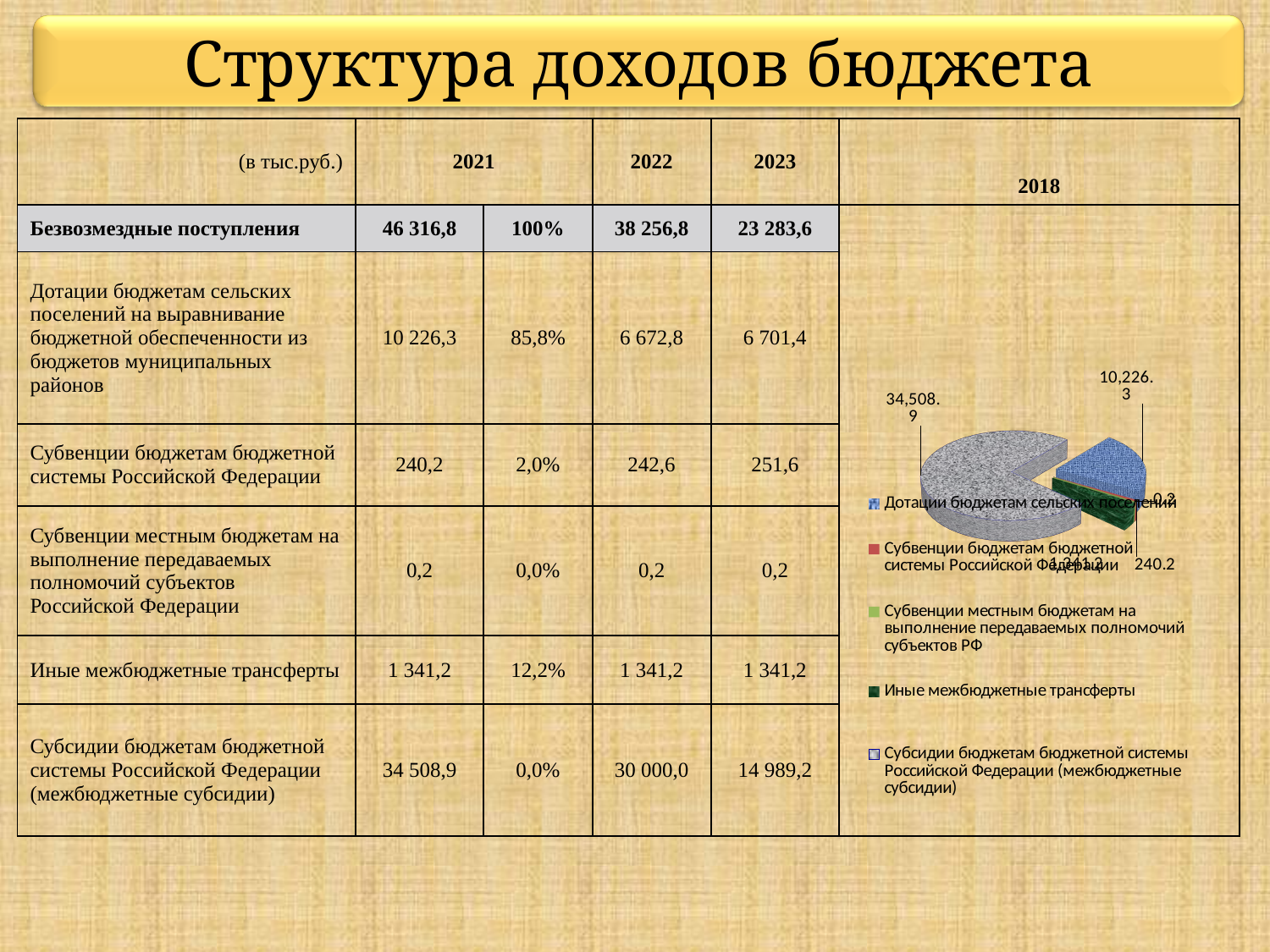
In the pie chart, what value is labelled for Дотации бюджетам сельских поселений? 10,226.3 How many entries does the legend of the pie chart list? 5 What is the title of the pie chart? 2018 In the pie chart, which is larger: the value for Дотации бюджетам сельских поселений or the value for Субвенции бюджетам бюджетной системы Российской Федерации? Дотации бюджетам сельских поселений What kind of chart is shown on the right of the slide? pie chart What colour is the largest slice of the pie chart? grey Which category has the smallest slice in the pie chart? Субвенции местным бюджетам на выполнение передаваемых полномочий субъектов РФ In the pie chart, what value is labelled for Субвенции местным бюджетам на выполнение передаваемых полномочий субъектов РФ? 0.2 In the pie chart, what is the difference between the value for Субсидии бюджетам бюджетной системы Российской Федерации (межбюджетные субсидии) and the value for Дотации бюджетам сельских поселений? 24,282.6 In the pie chart, what value is labelled for Субсидии бюджетам бюджетной системы Российской Федерации (межбюджетные субсидии)? 34,508.9 In the pie chart, what value is labelled for Субвенции бюджетам бюджетной системы Российской Федерации? 240.2 Which category has the largest slice in the pie chart? Субсидии бюджетам бюджетной системы Российской Федерации (межбюджетные субсидии)